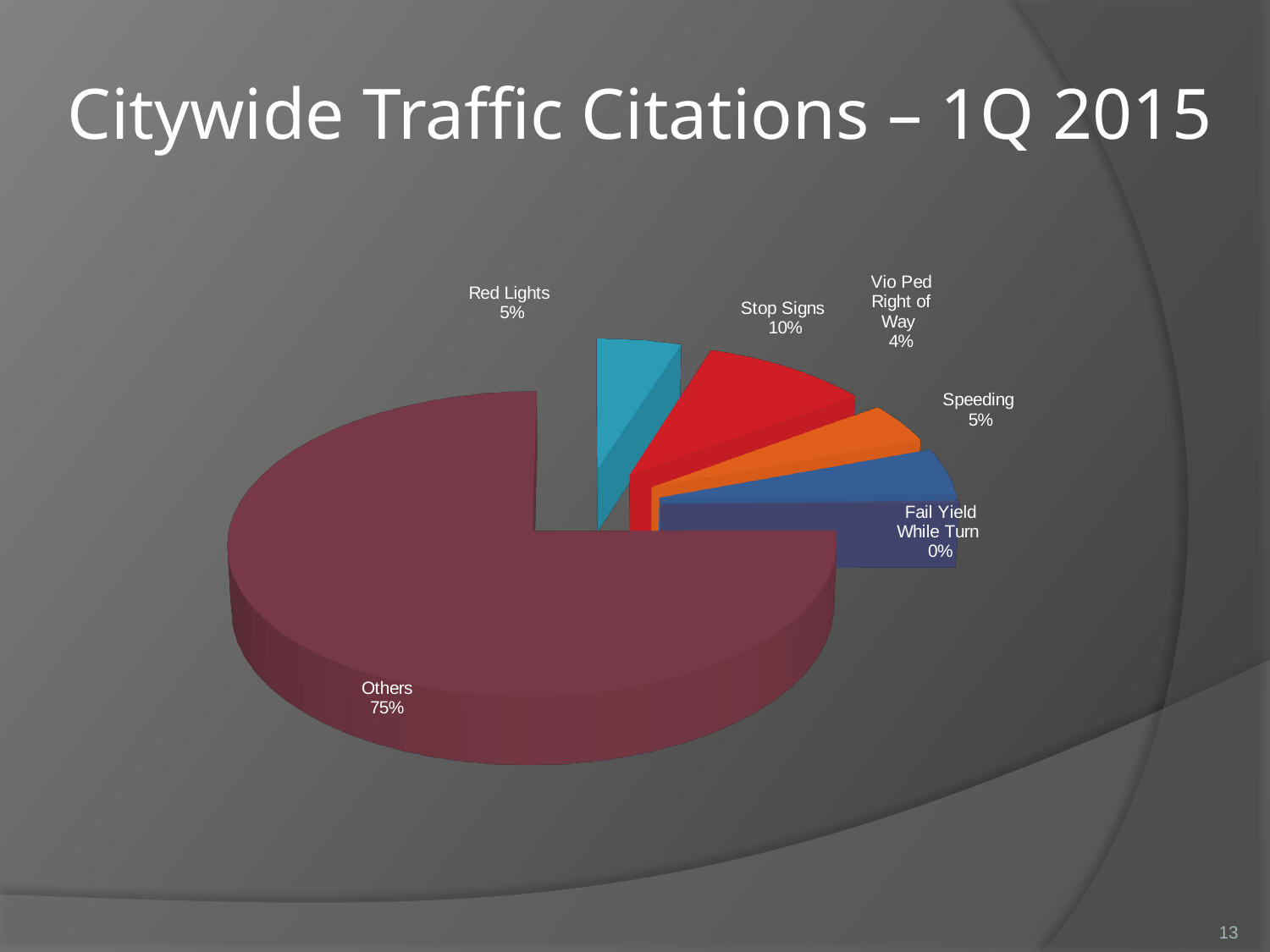
How many categories are shown in the pie chart? 6 How many percentage points larger is the Others share than the Stop Signs share? 65 percentage points What share of citations is labelled for Others? 75% Which category has the largest share of the pie? Others Which category has the smallest labelled share? Fail Yield While Turn What percentage is shown for Vio Ped Right of Way? 4% Which is larger, the share for Stop Signs or the share for Red Lights? Stop Signs What percentage is shown for Speeding? 5% What percentage is shown for Red Lights? 5% What percentage is shown for Fail Yield While Turn? 0% What percentage is shown for Stop Signs? 10% What kind of chart is shown on the slide? Pie chart